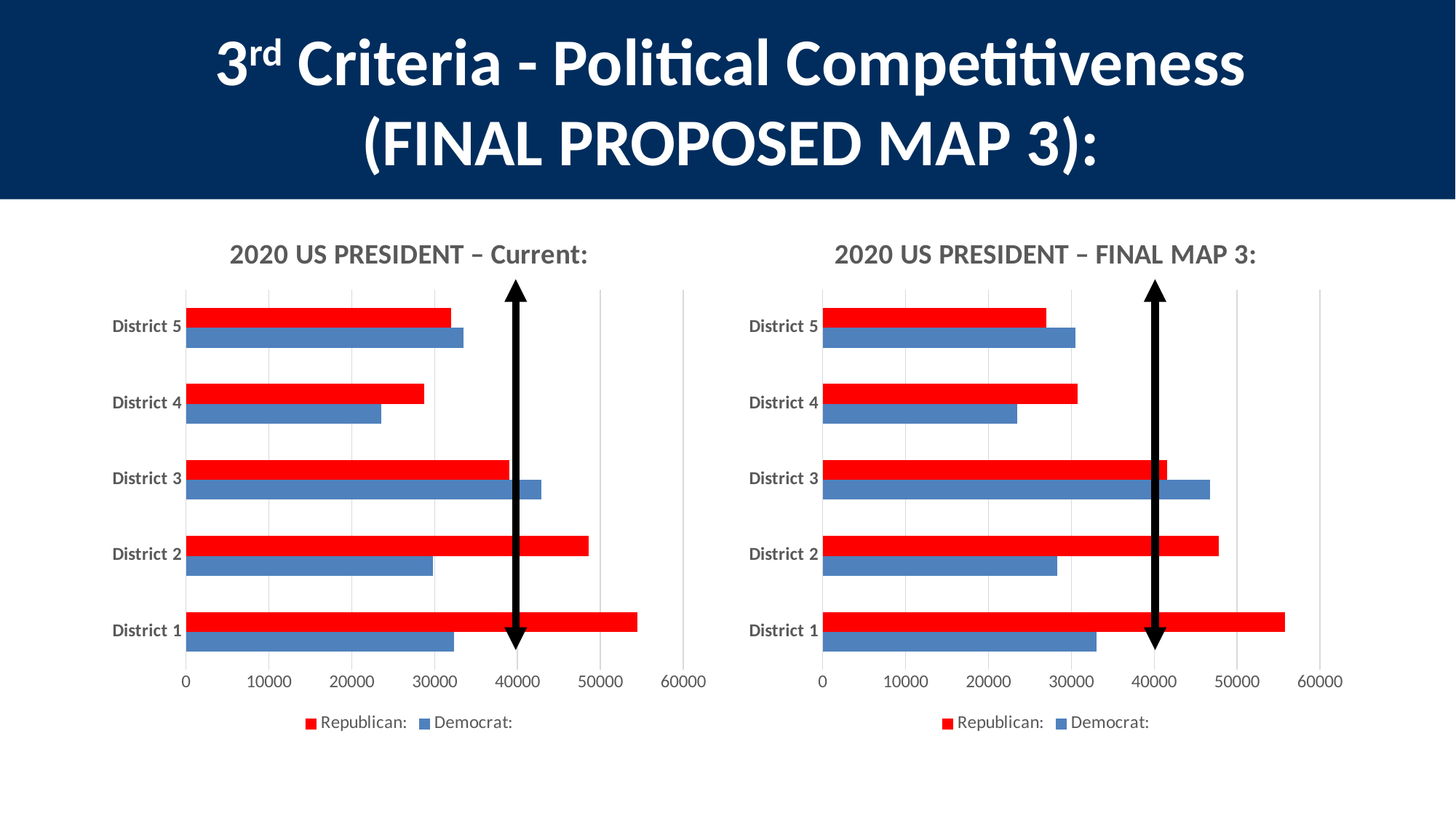
On the chart titled "2020 US PRESIDENT – FINAL MAP 3:", what colour are the Democrat bars? blue On the chart titled "2020 US PRESIDENT – FINAL MAP 3:", which is larger for District 2, the Republican or the Democrat value? Republican On the chart titled "2020 US PRESIDENT – Current:", how many series does the legend list? 2 On the chart titled "2020 US PRESIDENT – FINAL MAP 3:", is the Democrat value for District 4 greater or less than 30000? less On the chart titled "2020 US PRESIDENT – Current:", is the Republican value for District 1 greater or less than 50000? greater On the chart titled "2020 US PRESIDENT – FINAL MAP 3:", which district has the highest Democrat value? District 3 On the chart titled "2020 US PRESIDENT – Current:", which district has the highest Republican value? District 1 On the chart titled "2020 US PRESIDENT – FINAL MAP 3:", which district has the lowest Republican value? District 5 On the chart titled "2020 US PRESIDENT – Current:", how many districts are plotted? 5 On the chart titled "2020 US PRESIDENT – Current:", what kind of chart is shown? bar chart On the chart titled "2020 US PRESIDENT – Current:", which district has the lowest Democrat value? District 4 On the chart titled "2020 US PRESIDENT – Current:", which is larger for District 3, the Republican or the Democrat value? Democrat